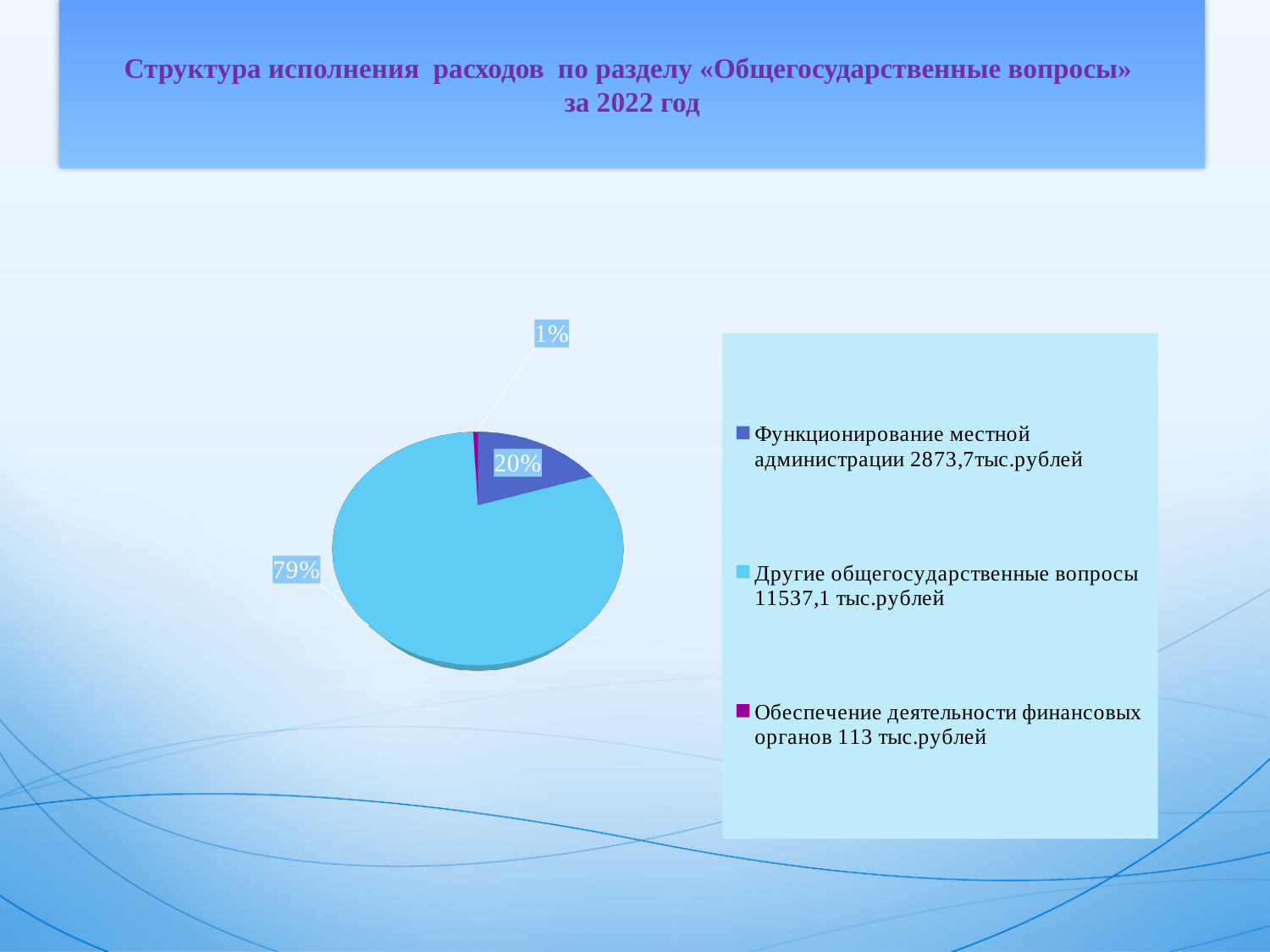
Which is larger: the share for "Функционирование местной администрации" or the share for "Обеспечение деятельности финансовых органов"? Функционирование местной администрации What colour is the slice for "Обеспечение деятельности финансовых органов"? magenta (purple) What share of the pie does "Другие общегосударственные вопросы" take? 79% What share of the pie does "Функционирование местной администрации" take? 20% What amount in тыс.рублей does the legend give for "Обеспечение деятельности финансовых органов"? 113 тыс.рублей Which category has the largest slice of the pie? Другие общегосударственные вопросы By how many percentage points does the share of "Другие общегосударственные вопросы" exceed the share of "Функционирование местной администрации"? 59% Which category has the smallest slice of the pie? Обеспечение деятельности финансовых органов What amount in тыс.рублей does the legend give for "Функционирование местной администрации"? 2873,7 тыс.рублей How many slices does the pie chart have? 3 What share of the pie does "Обеспечение деятельности финансовых органов" take? 1% What kind of chart is shown on the slide? pie chart